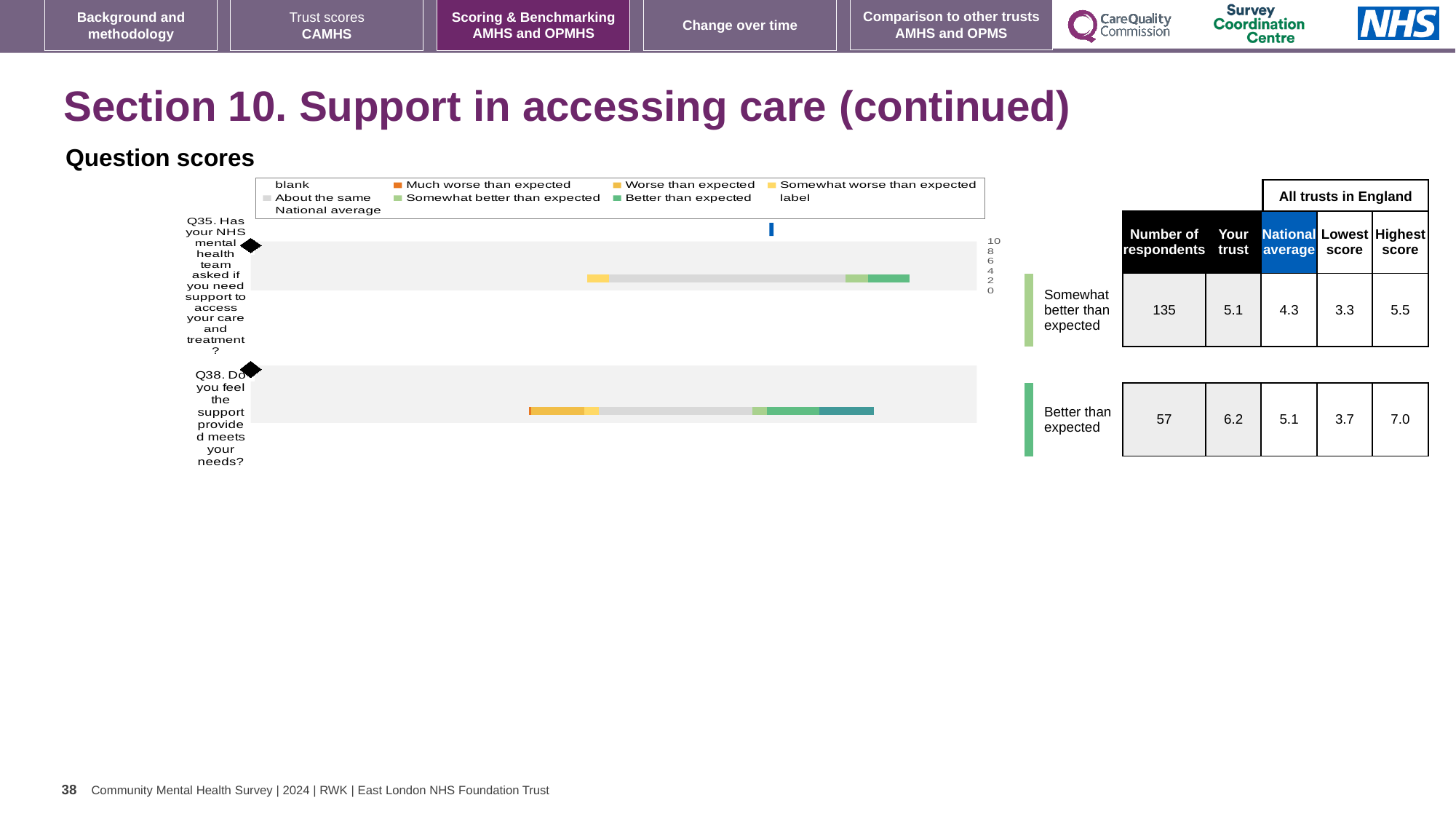
What kind of chart is used to show the question scores on this slide? bar chart What is the 'Your trust' score for Q35 in the question scores table? 5.1 Which benchmark category is shown for Q35 in the question scores chart? Somewhat better than expected How many entries does the legend of the question scores chart list? 9 What is the 'Your trust' score for Q38 in the question scores table? 6.2 What is the heading above the chart on this slide? Question scores Which legend entry in the question scores chart is shown in orange? Much worse than expected What is the difference between the 'Your trust' score and the national average for Q38? 1.1 How many questions are plotted in the question scores chart? 2 Which question has the higher 'Your trust' score, Q35 or Q38? Q38 How many respondents are listed for Q35? 135 Which benchmark category is shown for Q38 in the question scores chart? Better than expected